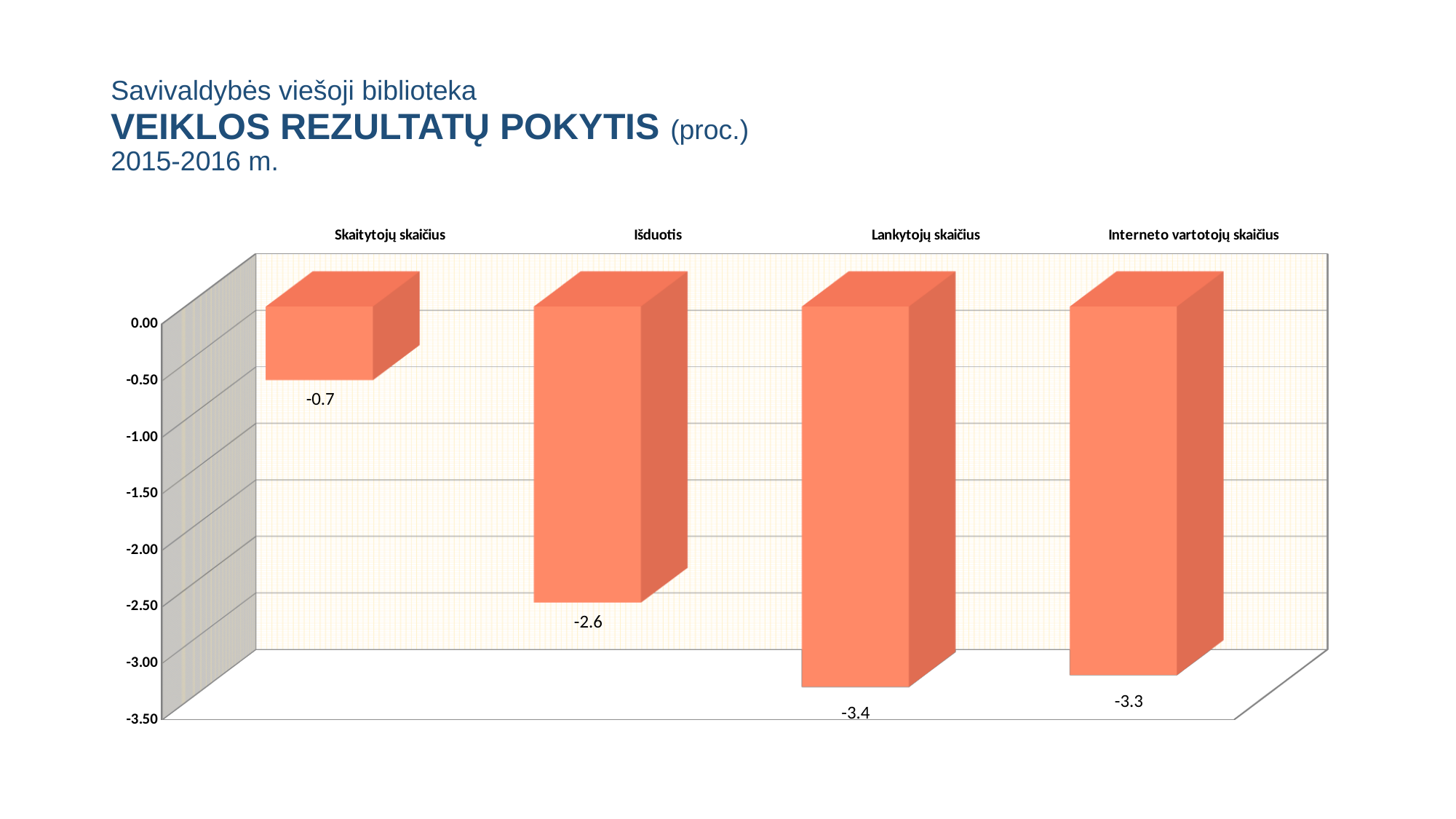
What kind of chart is shown on the slide? bar chart What is the value for Skaitytojų skaičius? -0.7 What is the value for Interneto vartotojų skaičius? -3.3 What is the value for Išduotis? -2.6 Which category has the highest value? Skaitytojų skaičius How many categories are shown in the chart? 4 What is the difference between the values for Lankytojų skaičius and Interneto vartotojų skaičius? 0.1 Which is larger, the value for Išduotis or the value for Lankytojų skaičius? Išduotis What is the difference between the values for Skaitytojų skaičius and Išduotis? 1.9 What is the value for Lankytojų skaičius? -3.4 Is the value for Išduotis greater or less than -2.00? less Which category has the lowest value? Lankytojų skaičius